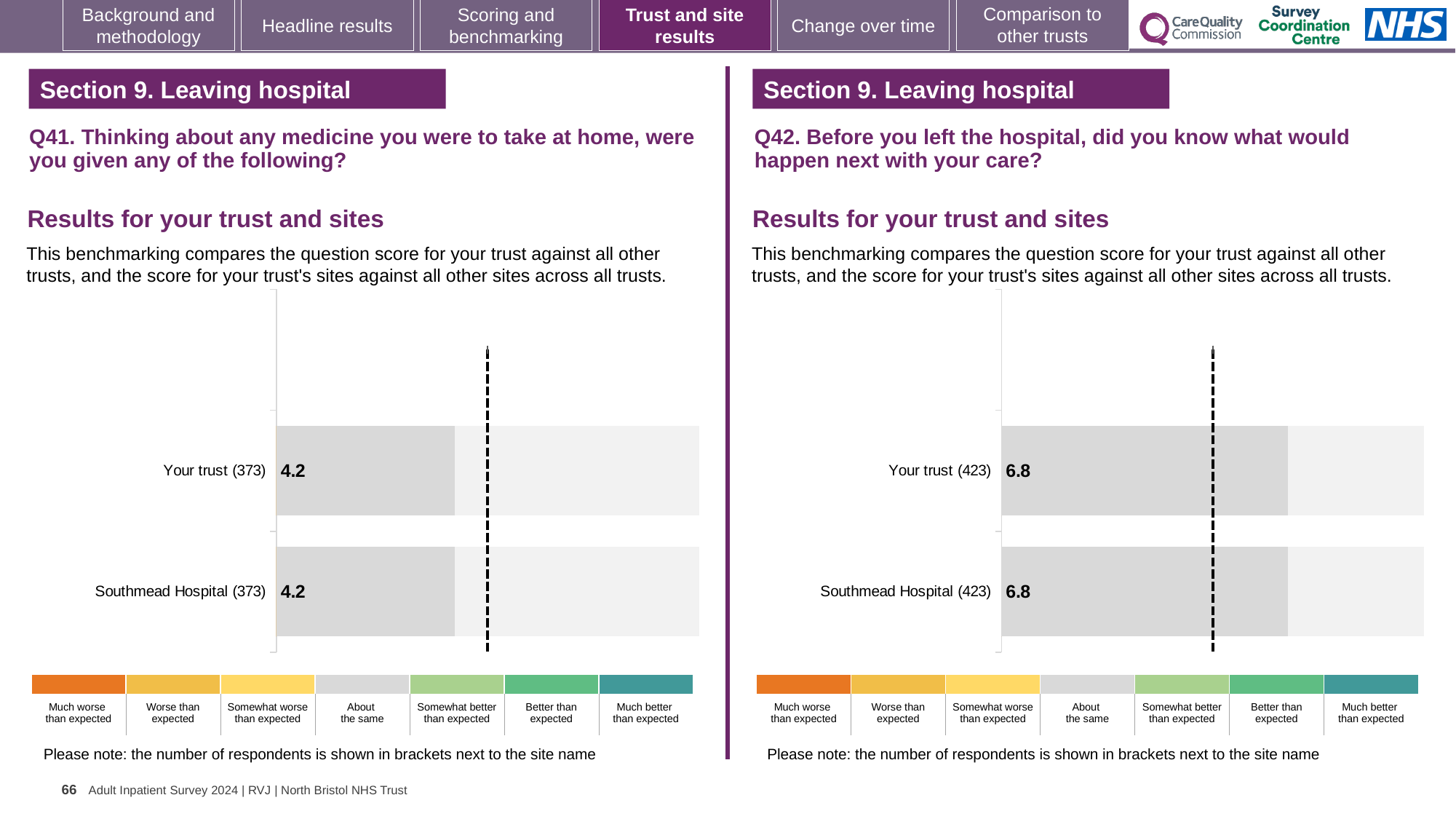
In the Q42 chart on the right, what is the score for Southmead Hospital? 6.8 In the Q41 chart on the left, what is the score for Your trust? 4.2 In the Q41 chart on the left, what is the score for Southmead Hospital? 4.2 In the Q42 chart on the right, how many respondents are shown in brackets for Your trust? 423 How many bars are plotted in the Q42 chart on the right? 2 How many rating categories does the colour key below the Q41 chart on the left list? 7 In the Q41 chart on the left, how many respondents are shown in brackets for Southmead Hospital? 373 In the Q42 chart on the right, what is the score for Your trust? 6.8 Which section heading appears above both charts on the slide? Section 9. Leaving hospital How many bars are plotted in the Q41 chart on the left? 2 In the Q41 chart on the left, what is the difference between the score for Your trust and the score for Southmead Hospital? 0 What kind of chart is used for the Q42 results on the right? Bar chart